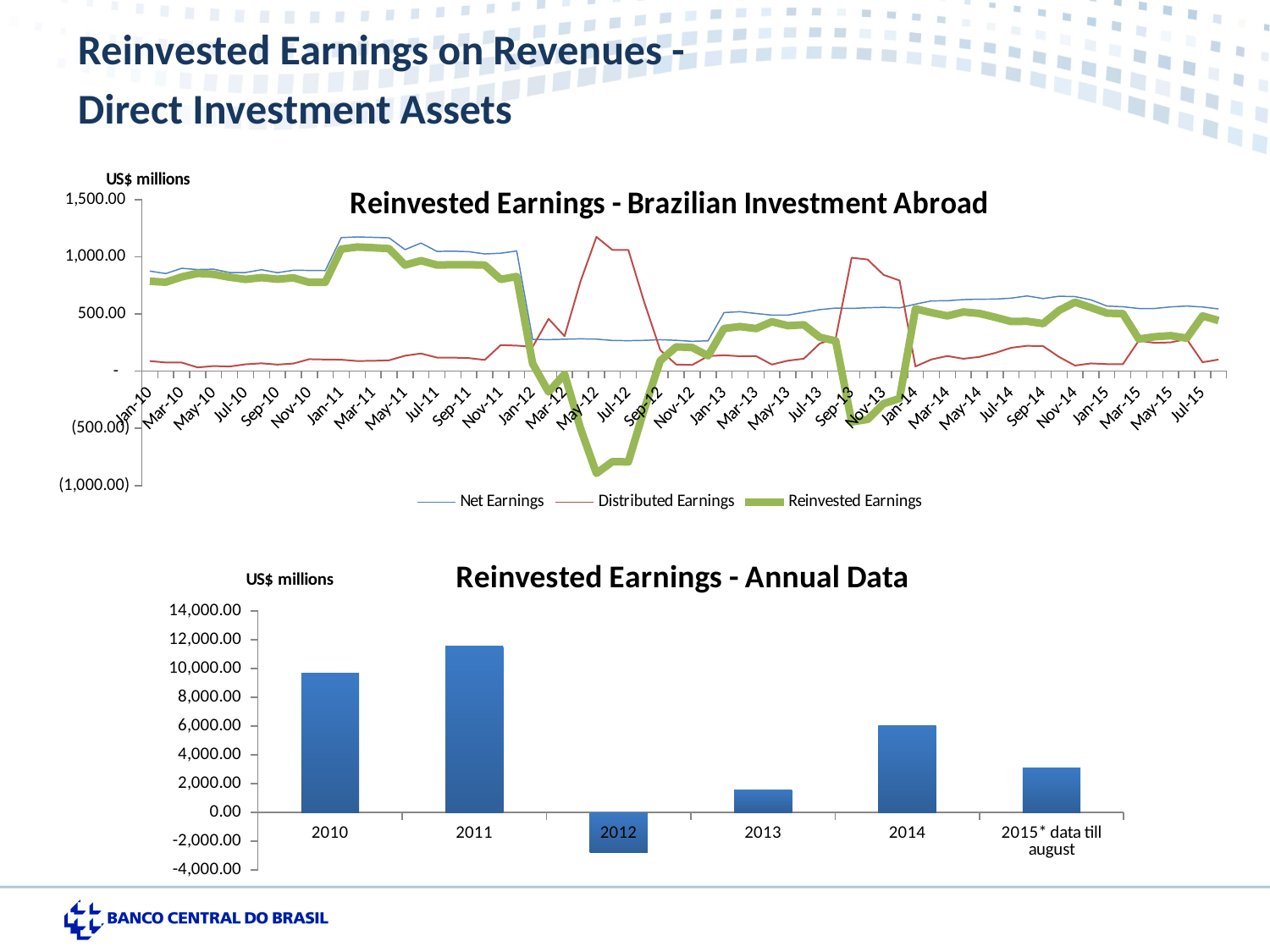
In the 'Reinvested Earnings - Annual Data' chart, is the value for 2012 greater or less than 0.00? less In the 'Reinvested Earnings - Brazilian Investment Abroad' chart, is the Net Earnings value for Jan-10 greater or less than 500.00? greater How many series does the legend of the 'Reinvested Earnings - Brazilian Investment Abroad' chart list? 3 In the 'Reinvested Earnings - Annual Data' chart, which is larger: the value for 2014 or the value for 2013? 2014 What kind of chart is the 'Reinvested Earnings - Annual Data' chart? bar chart In the 'Reinvested Earnings - Annual Data' chart, is the value for 2013 greater or less than 2,000.00? less In the 'Reinvested Earnings - Annual Data' chart, which year has the lowest value? 2012 What kind of chart is the 'Reinvested Earnings - Brazilian Investment Abroad' chart? line chart How many years (categories) are shown in the 'Reinvested Earnings - Annual Data' chart? 6 In the 'Reinvested Earnings - Annual Data' chart, which year has the highest value? 2011 What unit is shown above the y axis of both charts on the slide? US$ millions